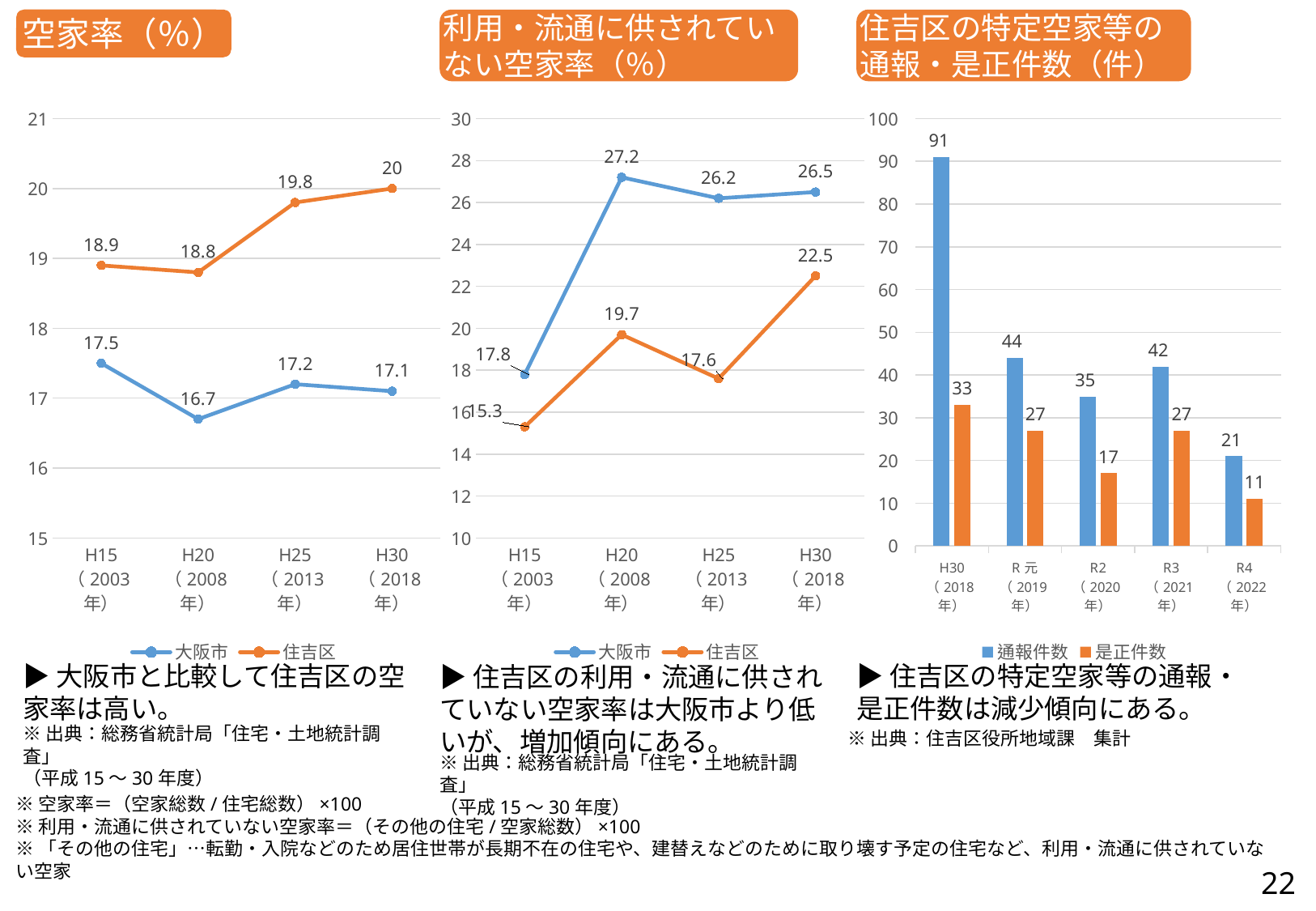
In the 住吉区の特定空家等の通報・是正件数（件） chart, what is the 通報件数 value for H30（2018年）? 91 In the 利用・流通に供されていない空家率（%） chart, in which year is the 住吉区 value lowest? H15（2003年） In the 空家率（%） chart, what is the value for 大阪市 in H20（2008年）? 16.7 In the 利用・流通に供されていない空家率（%） chart, what is the value for 大阪市 in H20（2008年）? 27.2 How many series does the legend of the 利用・流通に供されていない空家率（%） chart list? 2 In the 利用・流通に供されていない空家率（%） chart, what is the difference between 大阪市 and 住吉区 in H30（2018年）? 4 How many categories are shown on the x axis of the 住吉区の特定空家等の通報・是正件数（件） chart? 5 In the 空家率（%） chart, what is the difference between 住吉区 and 大阪市 in H15（2003年）? 1.4 What kind of chart is the 住吉区の特定空家等の通報・是正件数（件） chart? bar chart In the 住吉区の特定空家等の通報・是正件数（件） chart, in which year is 是正件数 lowest? R4（2022年） In the 空家率（%） chart, which series has the higher value in H25（2013年）, 大阪市 or 住吉区? 住吉区 In the 空家率（%） chart, what is the value for 住吉区 in H30（2018年）? 20